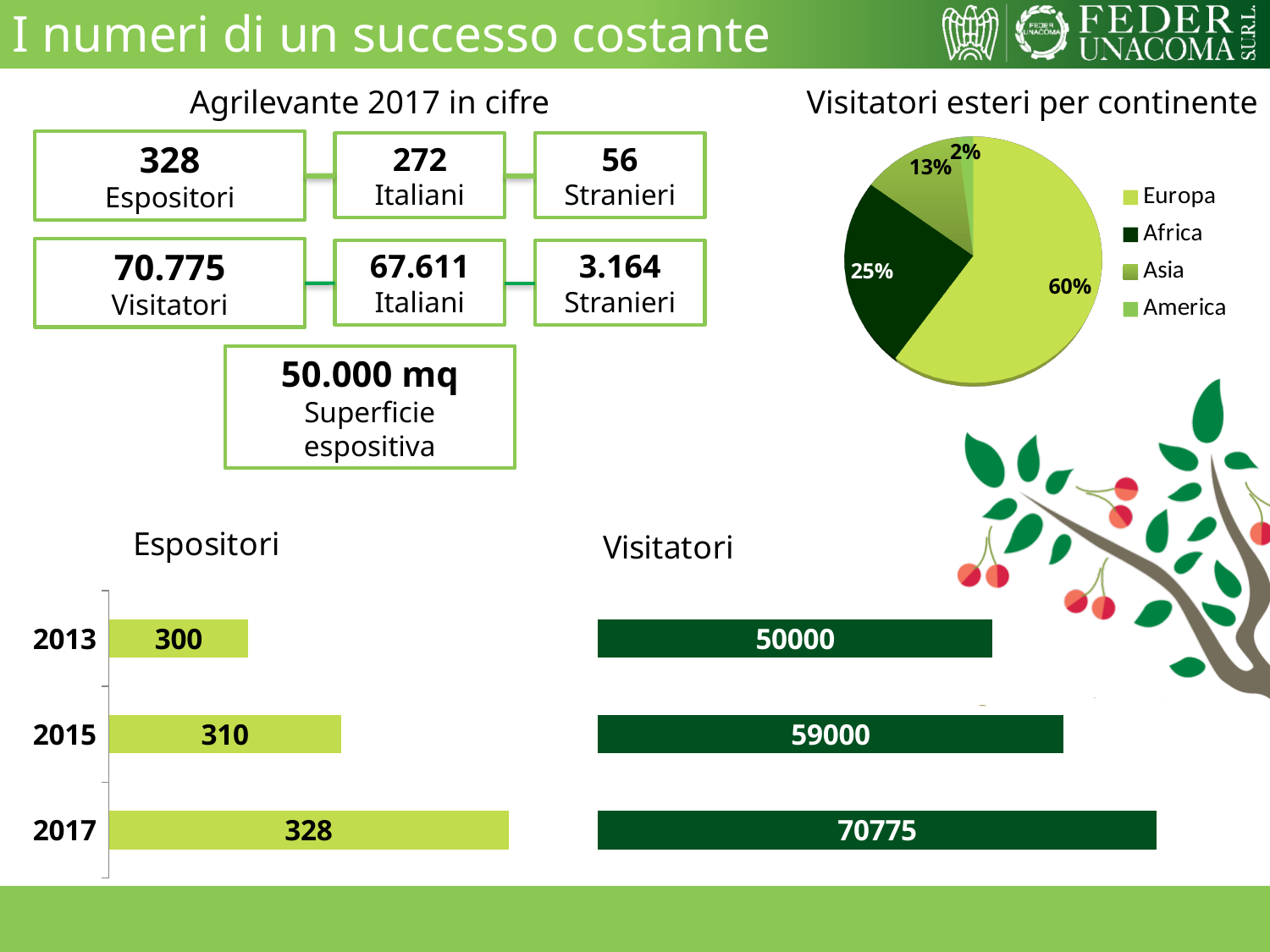
What kind of chart is 'Visitatori esteri per continente'? Pie chart In the 'Visitatori esteri per continente' pie chart, what is the difference in percentage points between the Europa and Asia slices? 47 In the 'Espositori' bar chart, what is the difference between the 2017 and 2013 values? 28 In the 'Visitatori esteri per continente' pie chart, what share of foreign visitors came from Europa? 60% In the 'Espositori' bar chart, what is the value for 2015? 310 In the 'Visitatori esteri per continente' pie chart, what share of foreign visitors came from Africa? 25% In the 'Visitatori' bar chart, do the values rise or fall from 2013 to 2017? Rise In the 'Espositori' bar chart, which year has the highest value? 2017 In the 'Visitatori esteri per continente' pie chart, how many continents are listed in the legend? 4 In the 'Visitatori' bar chart, what is the value for 2015? 59000 In the 'Visitatori' bar chart, what is the difference between the 2017 and 2013 values? 20775 In the 'Visitatori esteri per continente' pie chart, which continent has the smallest slice? America